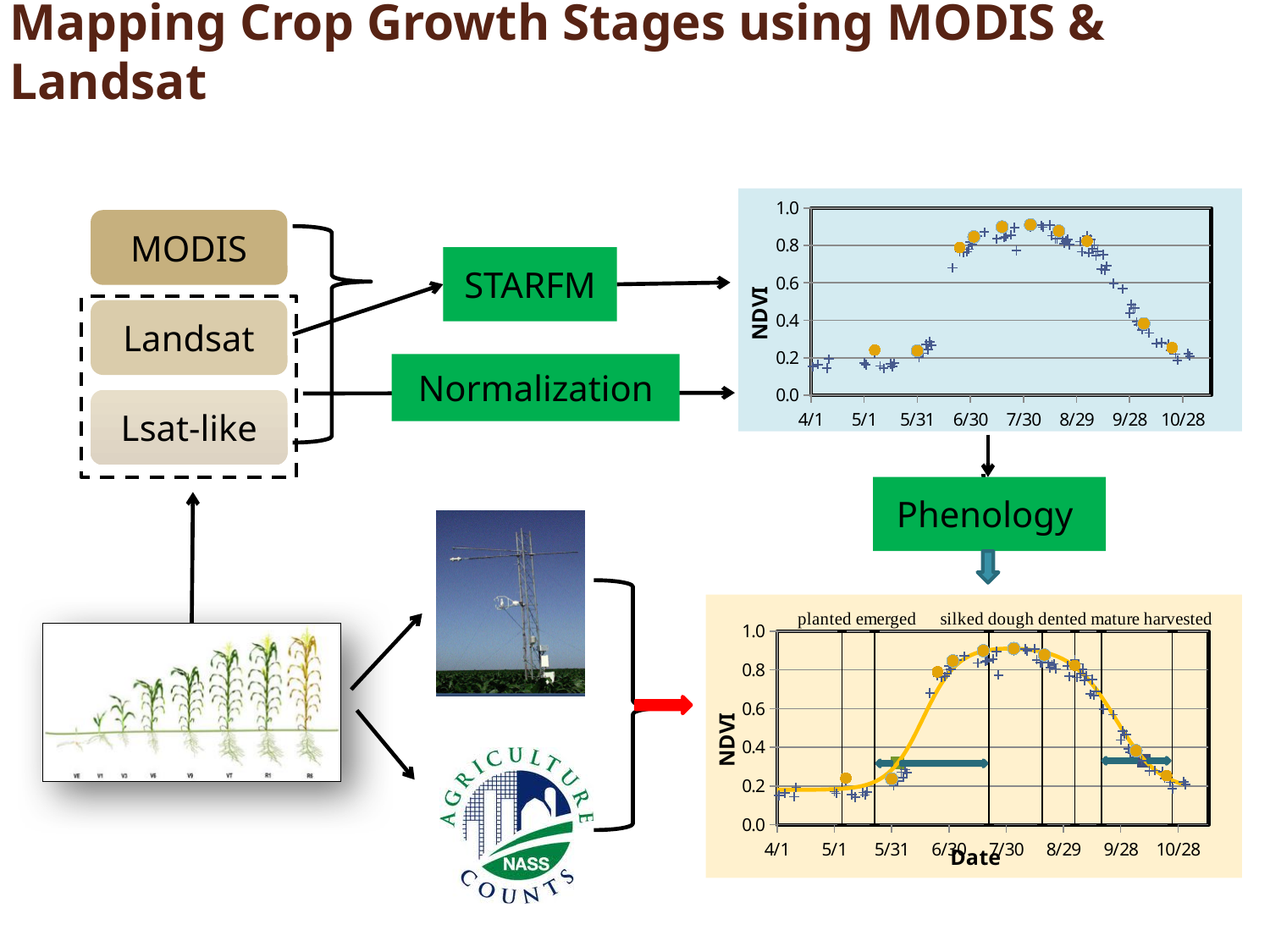
In the lower-right chart, do NDVI values rise or fall between 8/29 and 10/28? fall How many date tick labels are shown on the x-axis of the upper-right chart? 8 What is the x-axis label of the lower-right chart? Date In the upper-right chart, is the NDVI value around 7/30 greater or less than 0.8? greater In the upper-right chart, is the NDVI value around 10/28 greater or less than 0.4? less In the lower-right chart, is the NDVI value around 5/1 greater or less than 0.4? less What is the y-axis label of the upper-right chart? NDVI What is the maximum value shown on the y-axis of the lower-right chart? 1.0 In the upper-right chart, do NDVI values rise or fall between 5/31 and 7/30? rise What kind of chart is the upper-right chart on the slide? scatter chart